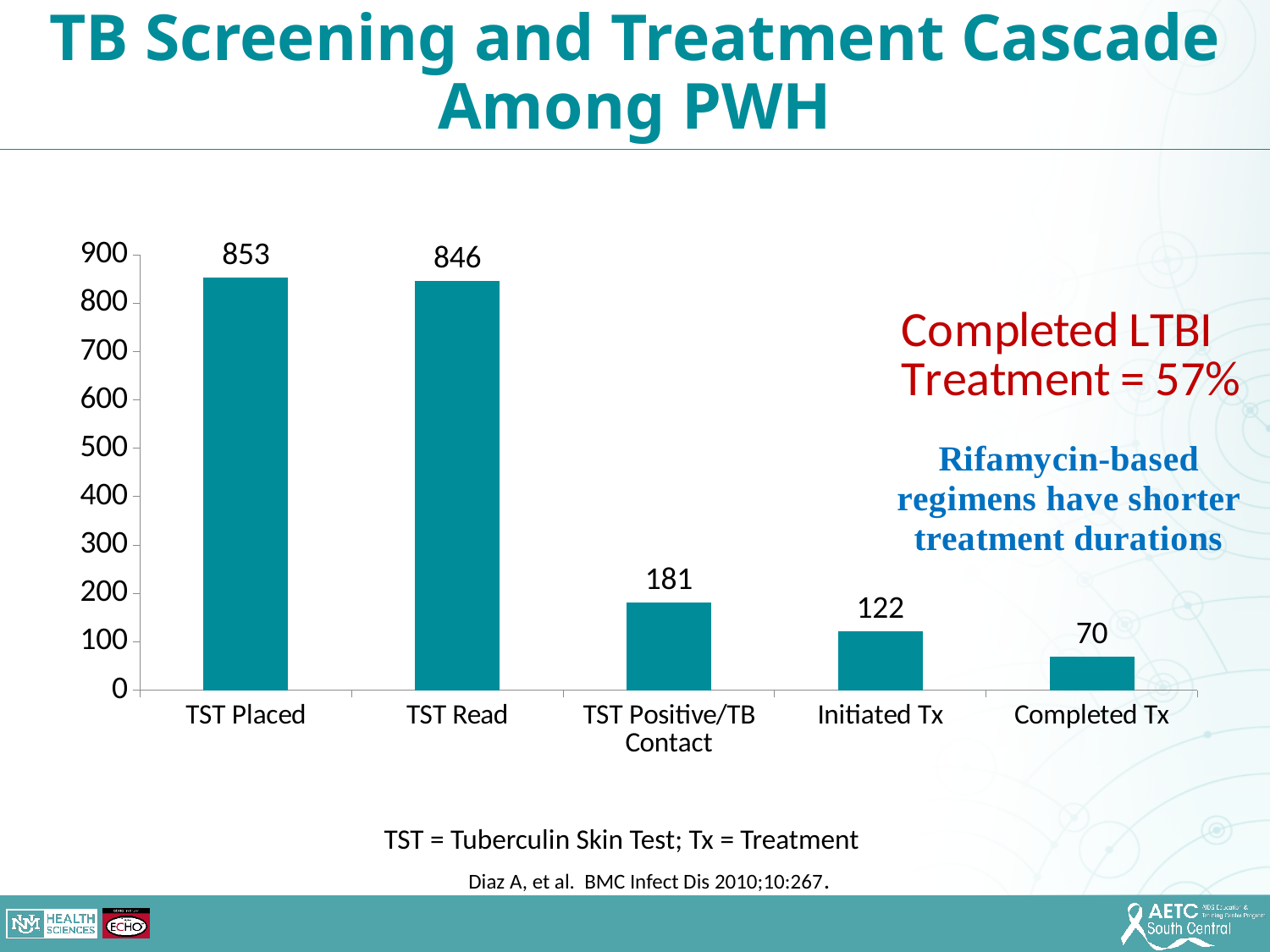
What kind of chart is shown on the slide? Bar chart What is the value for Completed Tx? 70 Which category has the lowest value? Completed Tx What is the value for Initiated Tx? 122 Which is larger, Initiated Tx or Completed Tx? Initiated Tx What is the value for TST Positive/TB Contact? 181 What is the difference between TST Positive/TB Contact and Initiated Tx? 59 Which category has the highest value? TST Placed What is the value for TST Read? 846 What is the value for TST Placed? 853 What is the difference between TST Placed and TST Read? 7 How many categories are shown on the x axis? 5